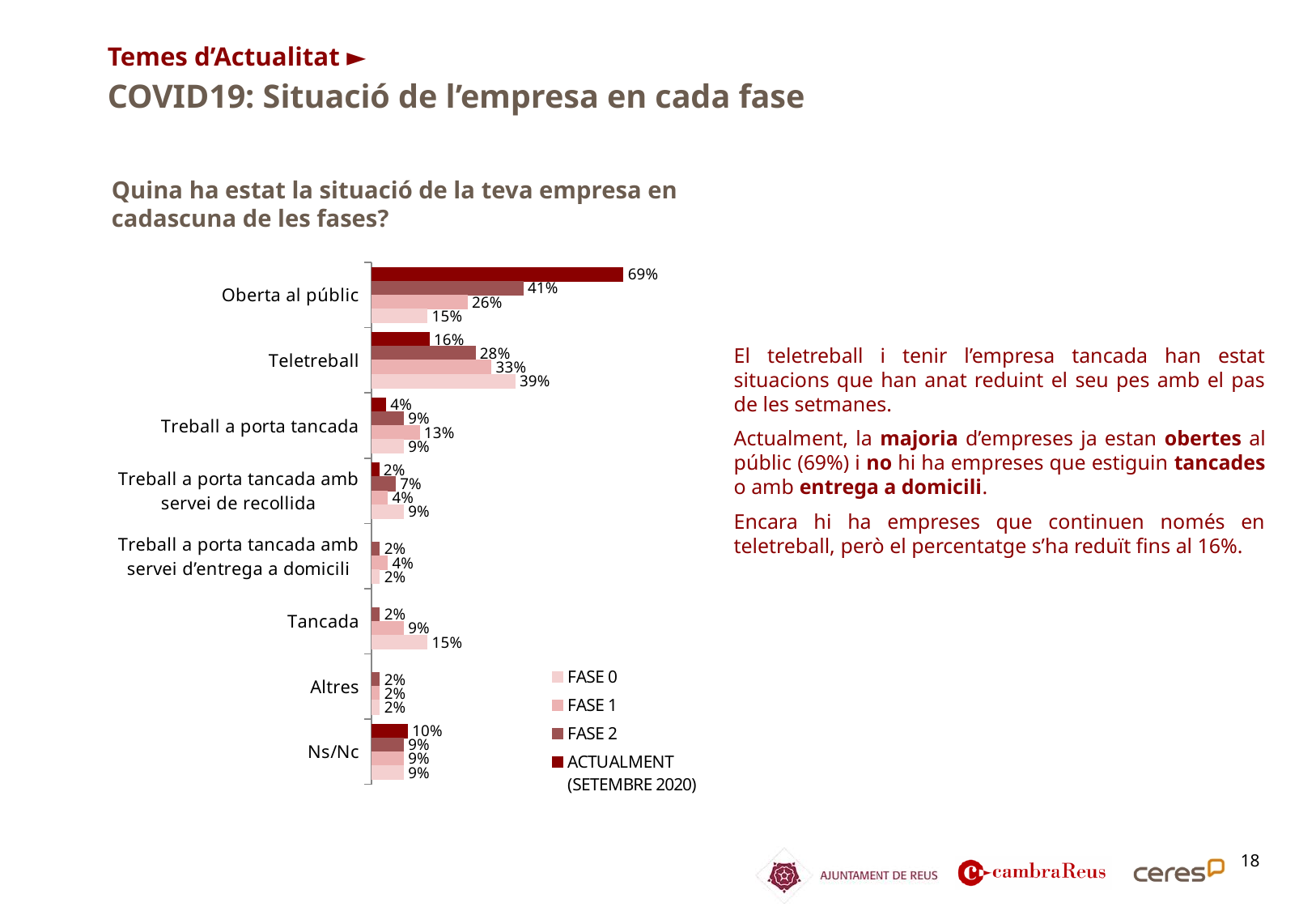
What kind of chart is shown on the slide? bar chart Which category has the highest value in the FASE 0 series? Teletreball What is the value for Tancada in the FASE 1 series? 9% Which legend entry is shown in the darkest colour? ACTUALMENT (SETEMBRE 2020) What is the value for Teletreball in the FASE 0 series? 39% What is the value for Treball a porta tancada in the FASE 1 series? 13% What is the difference between the ACTUALMENT (SETEMBRE 2020) and FASE 2 values for Oberta al públic? 28% For Teletreball, which is larger: the FASE 1 value or the ACTUALMENT (SETEMBRE 2020) value? FASE 1 How many series does the legend list? 4 How many categories are shown on the chart? 8 What is the value for Oberta al públic in the ACTUALMENT (SETEMBRE 2020) series? 69% Which category has the highest value in the ACTUALMENT (SETEMBRE 2020) series? Oberta al públic